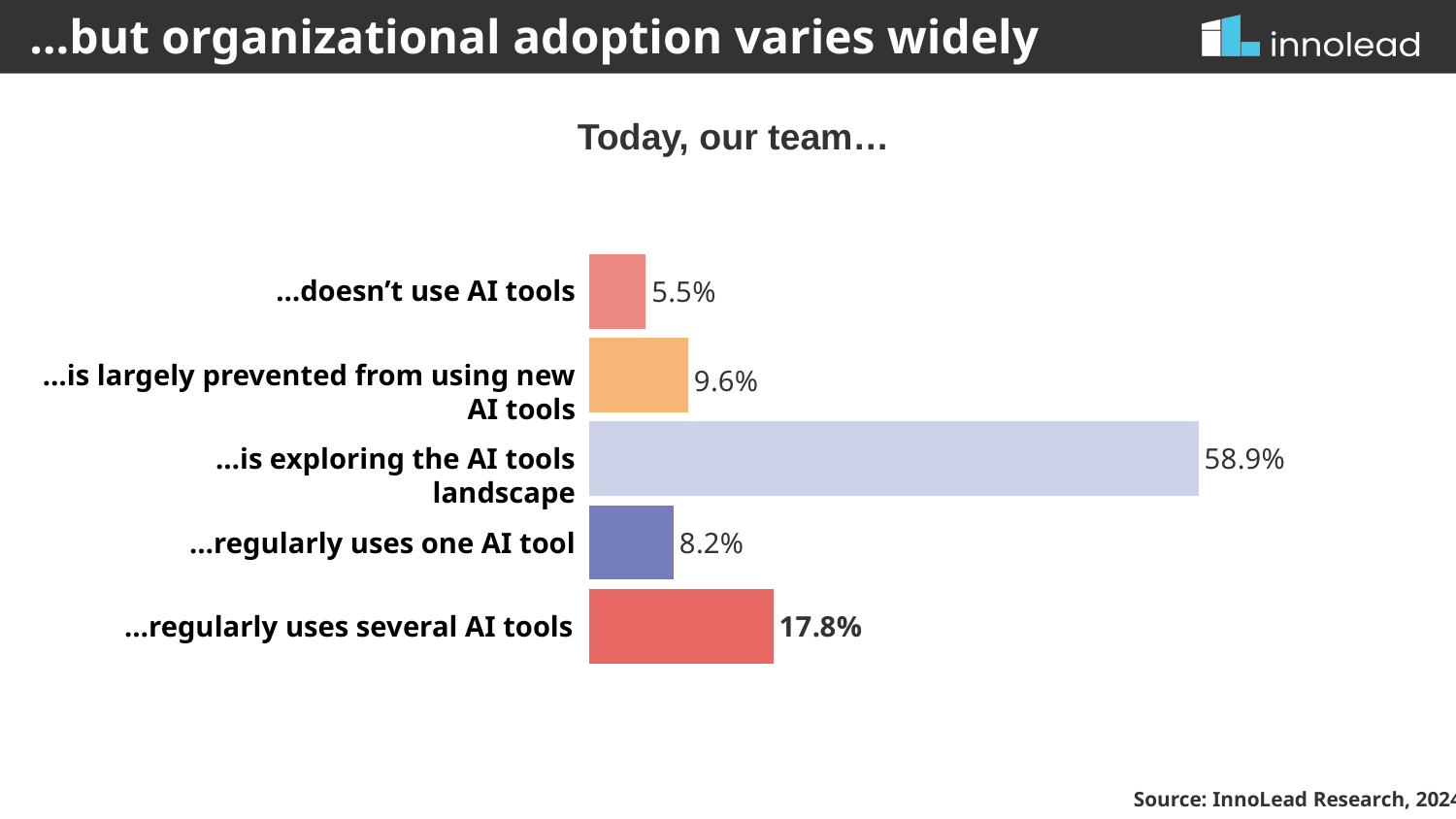
What is the difference between '...regularly uses several AI tools' and '...regularly uses one AI tool'? 9.6% What percentage of teams don't use AI tools? 5.5% What is the value for '...is largely prevented from using new AI tools'? 9.6% What kind of chart is shown on the slide? Bar chart Which is larger: '...is largely prevented from using new AI tools' or '...regularly uses one AI tool'? ...is largely prevented from using new AI tools How many categories are shown in the chart? 5 What percentage of teams regularly use several AI tools? 17.8% What is the title of the chart? Today, our team… What is the difference between '...is exploring the AI tools landscape' and '...doesn't use AI tools'? 53.4% What is the value for '...is exploring the AI tools landscape'? 58.9% Which category has the lowest value? ...doesn't use AI tools Which category has the highest value? ...is exploring the AI tools landscape